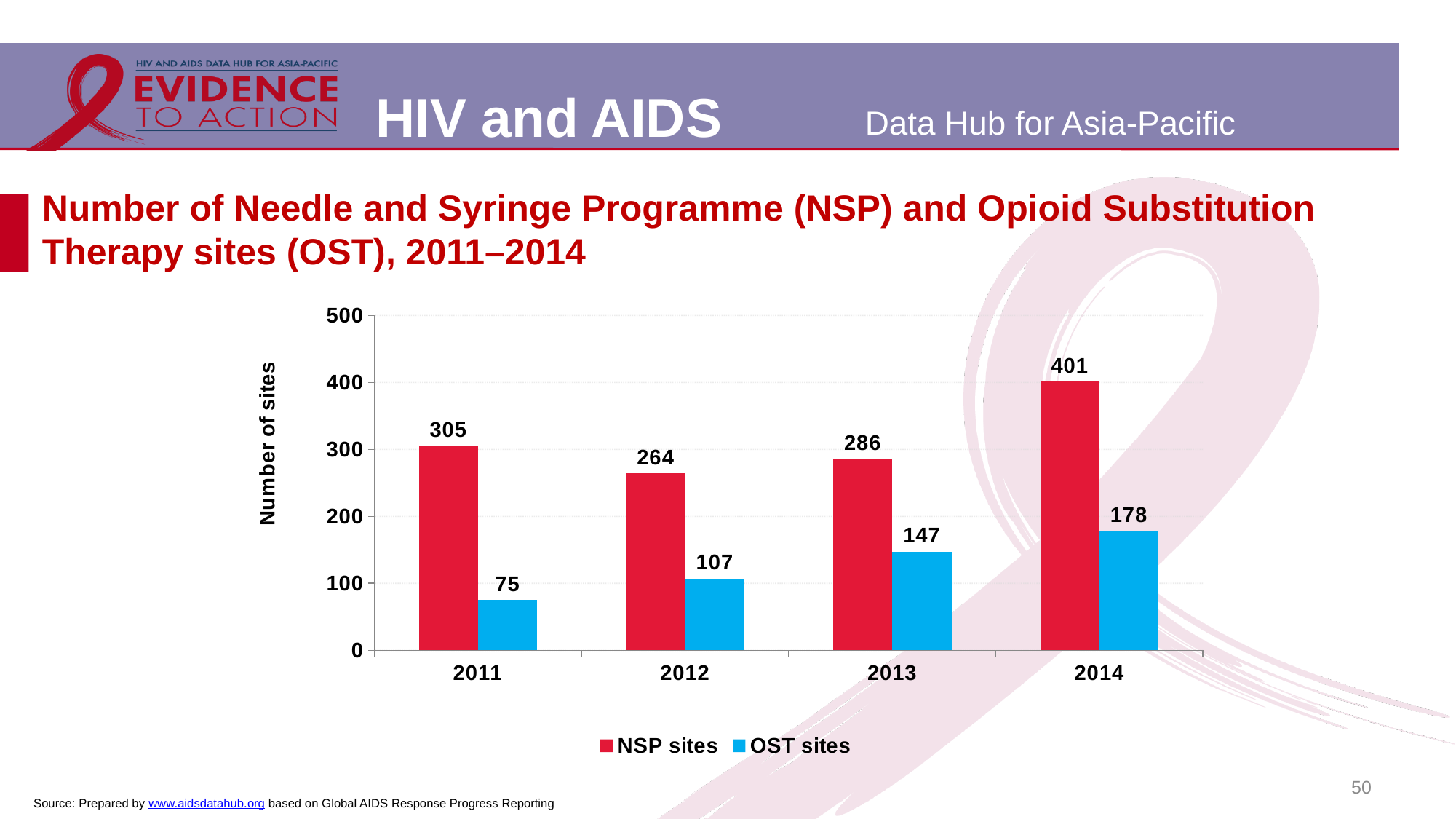
In which year was the number of OST sites lowest? 2011 What is the difference between NSP sites and OST sites in 2014? 223 How many OST sites were there in 2013? 147 What is the value for OST sites in 2014? 178 Is the value for OST sites in 2012 greater or less than 200? less How many series does the legend list? 2 Do the OST sites values rise or fall from 2011 to 2014? rise How many NSP sites were there in 2011? 305 By how much did the number of NSP sites change from 2011 to 2012? 41 In which year was the number of NSP sites highest? 2014 Which is larger: NSP sites in 2012 or NSP sites in 2013? NSP sites in 2013 How many years are shown on the x axis? 4